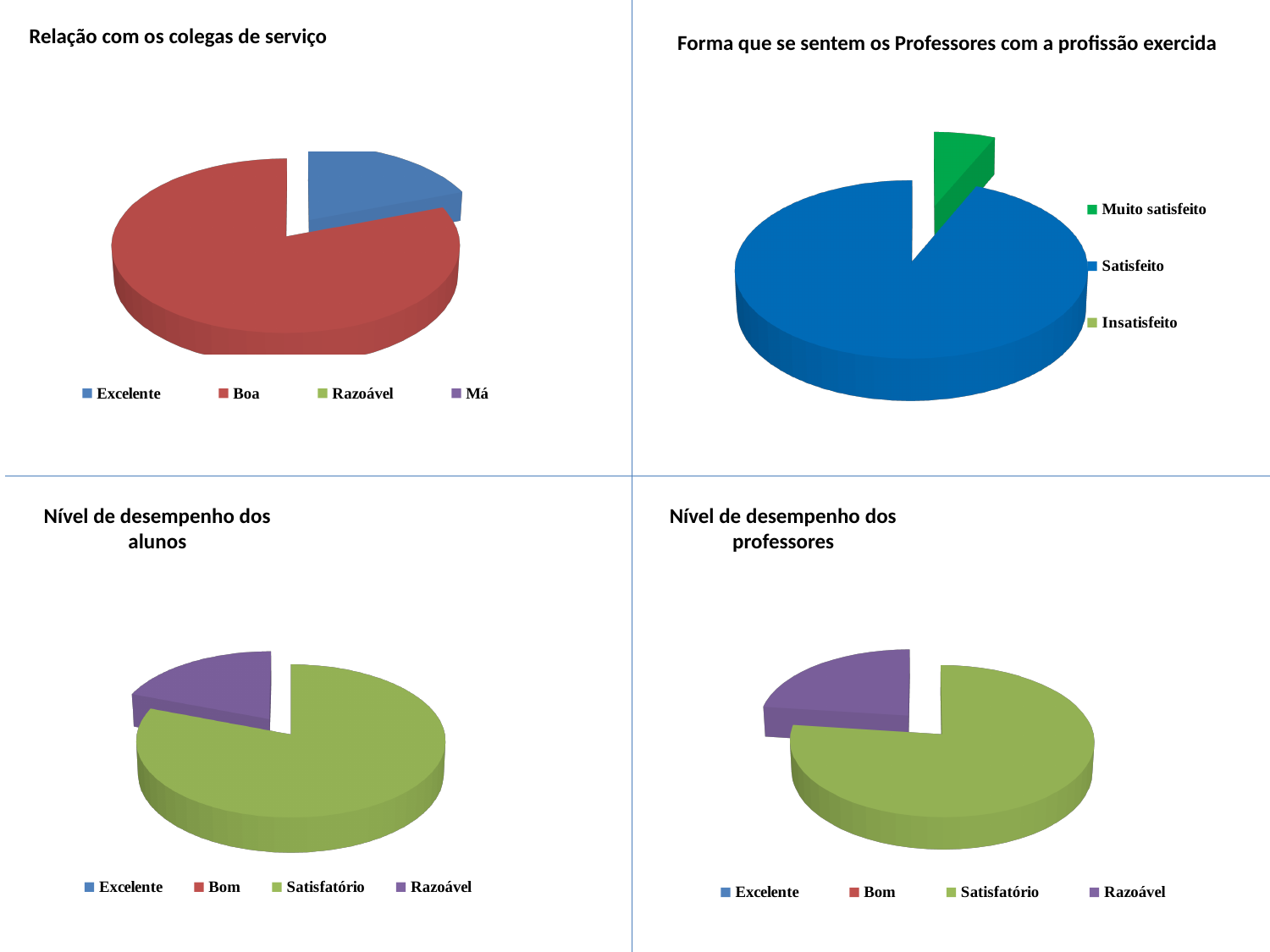
How many entries does the legend of 'Relação com os colegas de serviço' list? 4 How many entries does the legend of 'Forma que se sentem os Professores com a profissão exercida' list? 3 In the chart 'Relação com os colegas de serviço', which is larger, Excelente or Boa? Boa In the chart 'Nível de desempenho dos alunos', which category has the largest slice? Satisfatório In the chart 'Relação com os colegas de serviço', which category has the largest slice? Boa What kind of chart is 'Relação com os colegas de serviço'? pie chart In the chart 'Nível de desempenho dos alunos', which is larger, Razoável or Satisfatório? Satisfatório How many entries does the legend of 'Nível de desempenho dos professores' list? 4 In the chart 'Forma que se sentem os Professores com a profissão exercida', which is smaller, Muito satisfeito or Satisfeito? Muito satisfeito In the chart 'Forma que se sentem os Professores com a profissão exercida', which category has the largest slice? Satisfeito In the chart 'Forma que se sentem os Professores com a profissão exercida', what colour is the Muito satisfeito slice? green